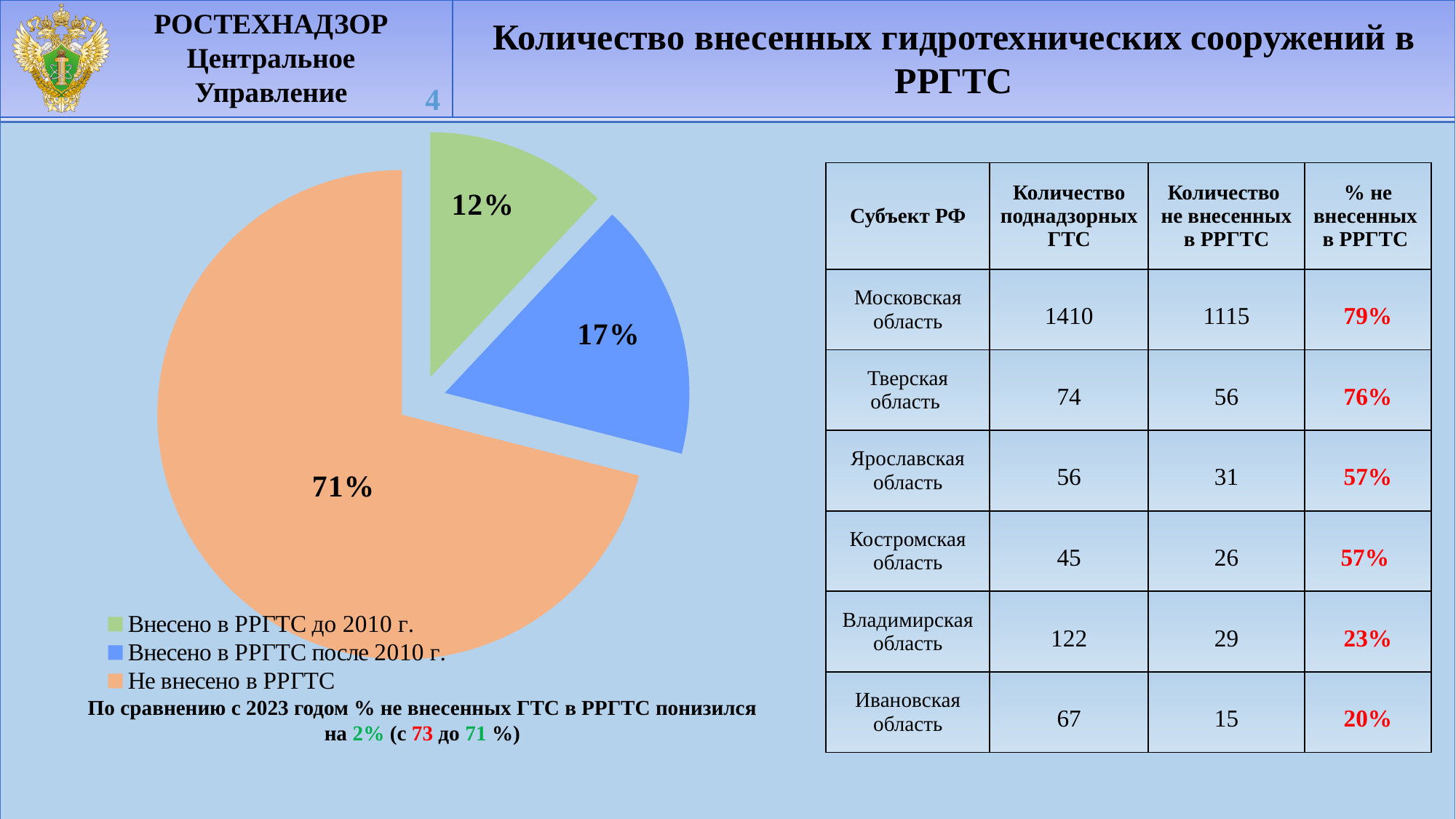
What colour is the "Внесено в РРГТС до 2010 г." slice in the pie chart? Green In the pie chart, what is the difference in percentage points between "Не внесено в РРГТС" and "Внесено в РРГТС после 2010 г."? 54 How many entries does the pie chart legend list? 3 How many slices does the pie chart have? 3 In the pie chart, which is larger: "Внесено в РРГТС до 2010 г." or "Внесено в РРГТС после 2010 г."? Внесено в РРГТС после 2010 г. What kind of chart is shown on the slide? Pie chart What share of the pie chart is labelled "Внесено в РРГТС до 2010 г."? 12% Which slice of the pie chart is the largest? Не внесено в РРГТС What share of the pie chart is labelled "Не внесено в РРГТС"? 71% What share of the pie chart is labelled "Внесено в РРГТС после 2010 г."? 17% Which slice of the pie chart is the smallest? Внесено в РРГТС до 2010 г. What colour is the "Не внесено в РРГТС" slice in the pie chart? Orange